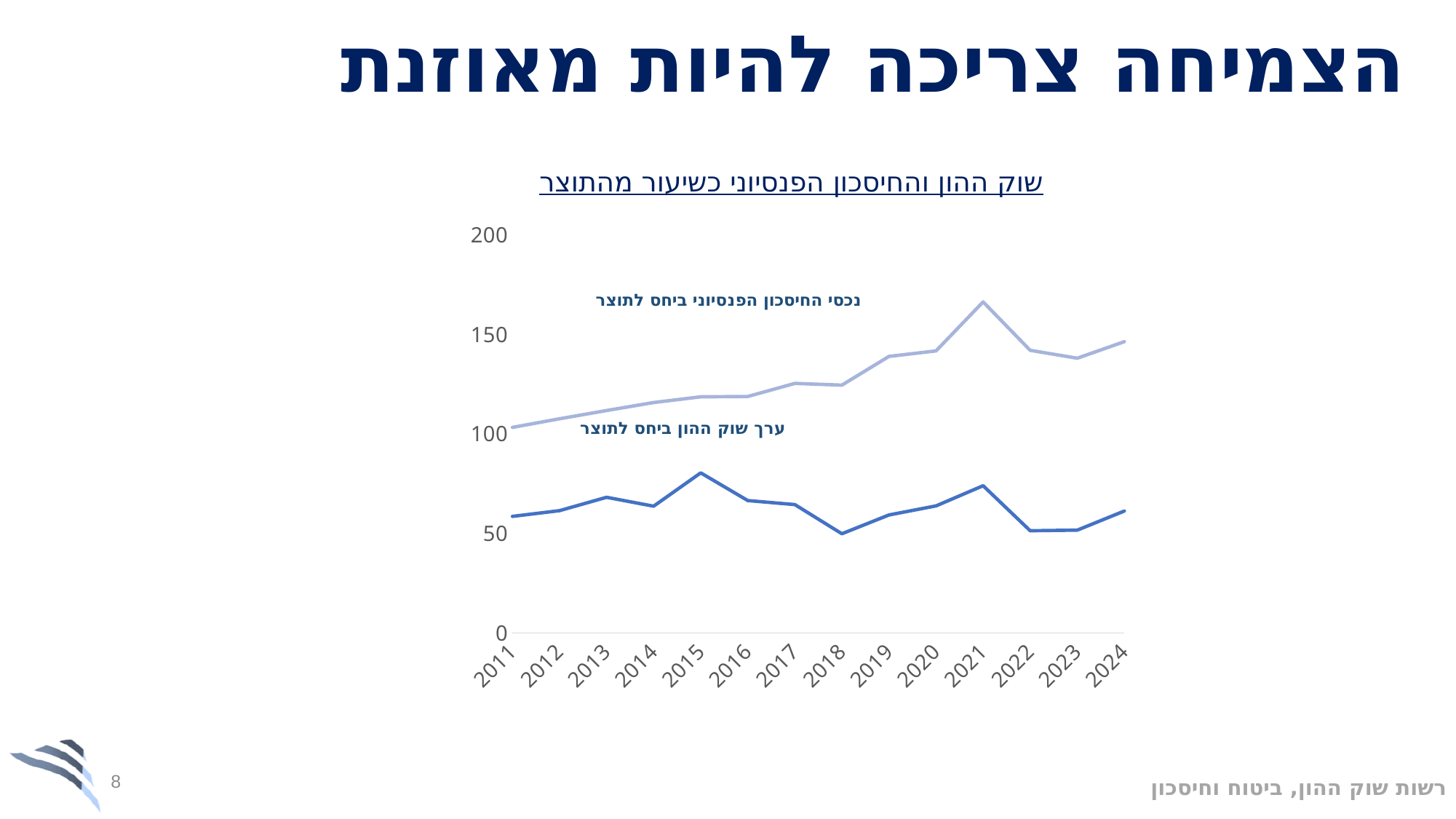
Is the value of 'נכסי החיסכון הפנסיוני ביחס לתוצר' in 2011 greater or less than 150? less In 2024, which series has the higher value: 'נכסי החיסכון הפנסיוני ביחס לתוצר' or 'ערך שוק ההון ביחס לתוצר'? נכסי החיסכון הפנסיוני ביחס לתוצר How many years are shown on the x axis of the chart? 14 In which year does the series 'נכסי החיסכון הפנסיוני ביחס לתוצר' reach its highest value? 2021 How many series are plotted in the chart? 2 Is the value of 'נכסי החיסכון הפנסיוני ביחס לתוצר' in 2021 greater or less than 150? greater Is the value of 'ערך שוק ההון ביחס לתוצר' in 2021 greater or less than 100? less What kind of chart is shown on the slide? line chart In which year is the series 'נכסי החיסכון הפנסיוני ביחס לתוצר' at its lowest value? 2011 What is the title of the chart? שוק ההון והחיסכון הפנסיוני כשיעור מהתוצר In which year does the series 'ערך שוק ההון ביחס לתוצר' reach its highest value? 2015